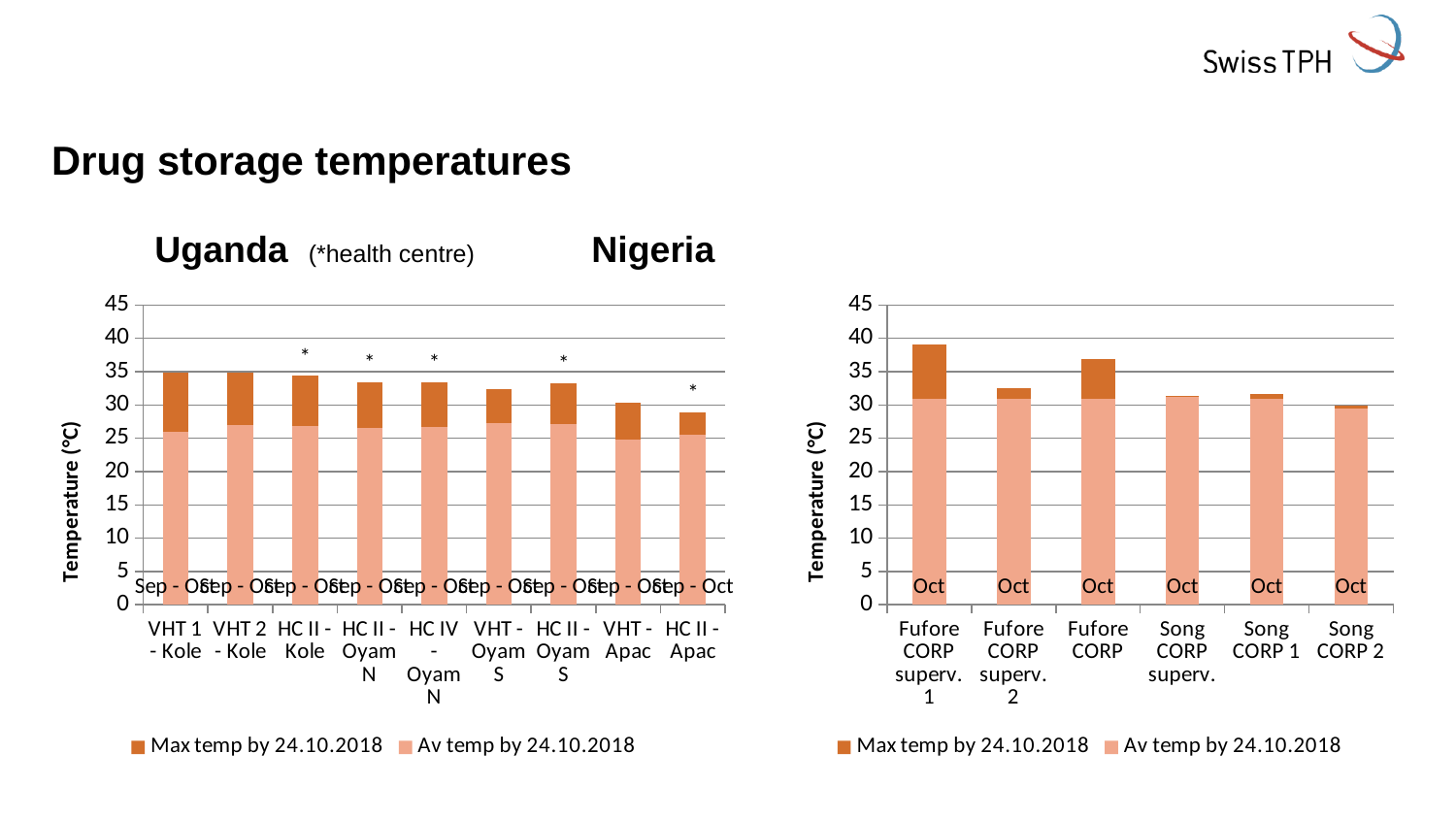
In the Uganda chart, which has the higher max temperature: VHT 1 - Kole or VHT - Apac? VHT 1 - Kole How many series does the legend of the Nigeria chart list? 2 In the Nigeria chart, which site has the lowest max temperature? Song CORP 2 In the Nigeria chart, which site has the highest max temperature? Fufore CORP superv. 1 In the Uganda chart, which site has the lowest max temperature? HC II - Apac In the Nigeria chart, is the max temperature for Fufore CORP superv. 1 greater or less than 35? greater In the Nigeria chart, which has the higher max temperature: Fufore CORP superv. 1 or Fufore CORP superv. 2? Fufore CORP superv. 1 How many categories (sites) are shown on the x axis of the Uganda chart? 9 In the Uganda chart, is the max temperature for VHT 1 - Kole greater or less than 30? greater How many categories (sites) are shown on the x axis of the Nigeria chart? 6 What type of chart is the Uganda chart? Bar chart What is the y-axis label on the Uganda chart? Temperature (°C)